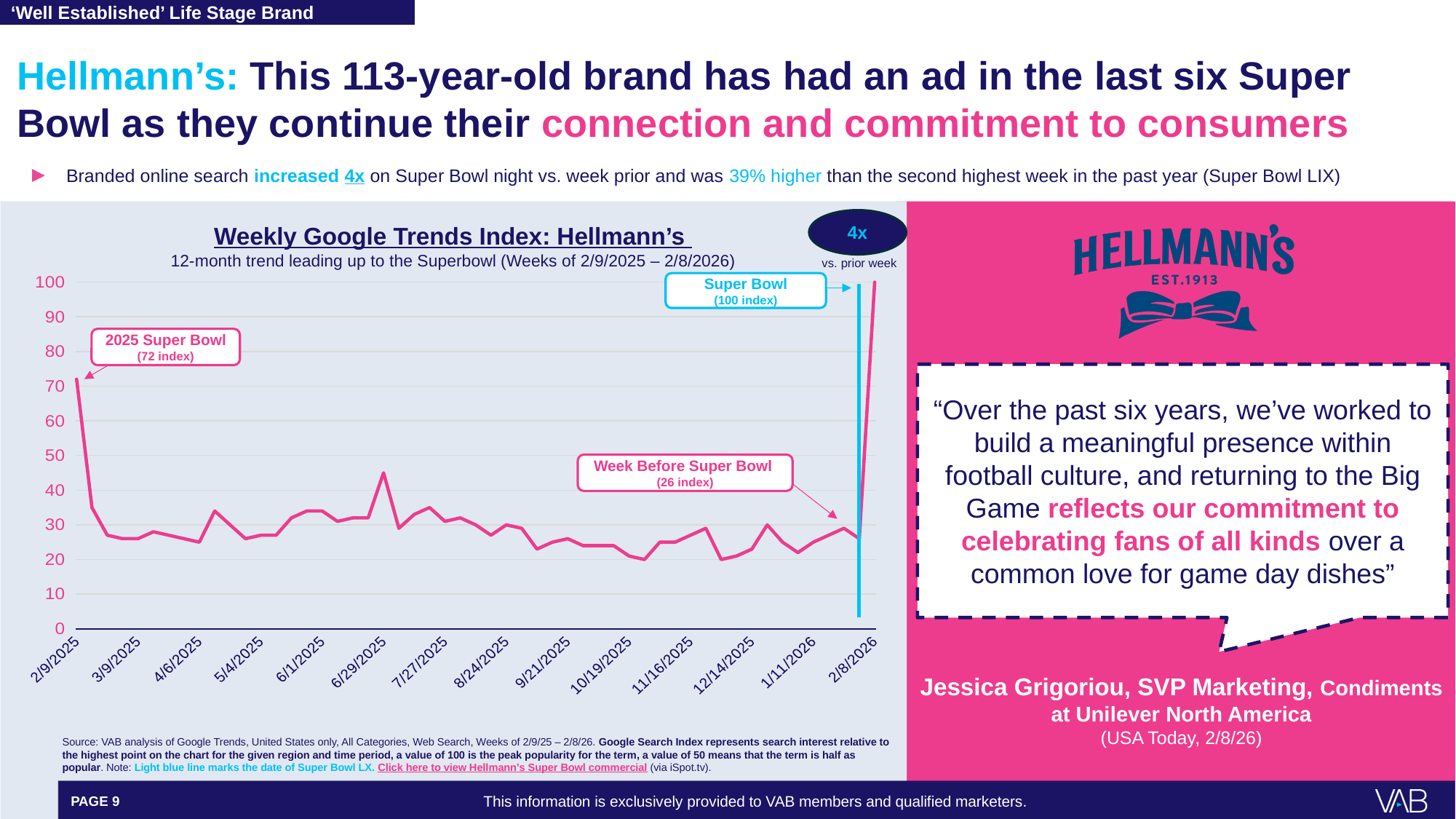
What index value is shown for the week before the Super Bowl on the chart? 26 Which week has the highest Google Trends index on the chart? 2/8/2026 (Super Bowl week) What is the difference between the Super Bowl week index (100) and the 2025 Super Bowl index (72)? 28 What kind of chart is used to show the Weekly Google Trends Index for Hellmann's? Line chart What is the Google Trends index value for the Super Bowl week (2/8/2026) on the Weekly Google Trends Index chart? 100 Between 2/9/2025 and 3/9/2025, does the index rise or fall? Fall How many date labels are shown on the x-axis of the chart? 14 Which is larger: the index for the 2025 Super Bowl week or the index for the week before the 2026 Super Bowl? 2025 Super Bowl week Is the index value for the week of 10/19/2025 greater or less than 30? less What index value is shown for the 2025 Super Bowl week on the chart? 72 By how many index points does the Super Bowl week (100 index) exceed the week before the Super Bowl (26 index)? 74 According to the chart note, what does the light blue vertical line mark? The date of Super Bowl LX